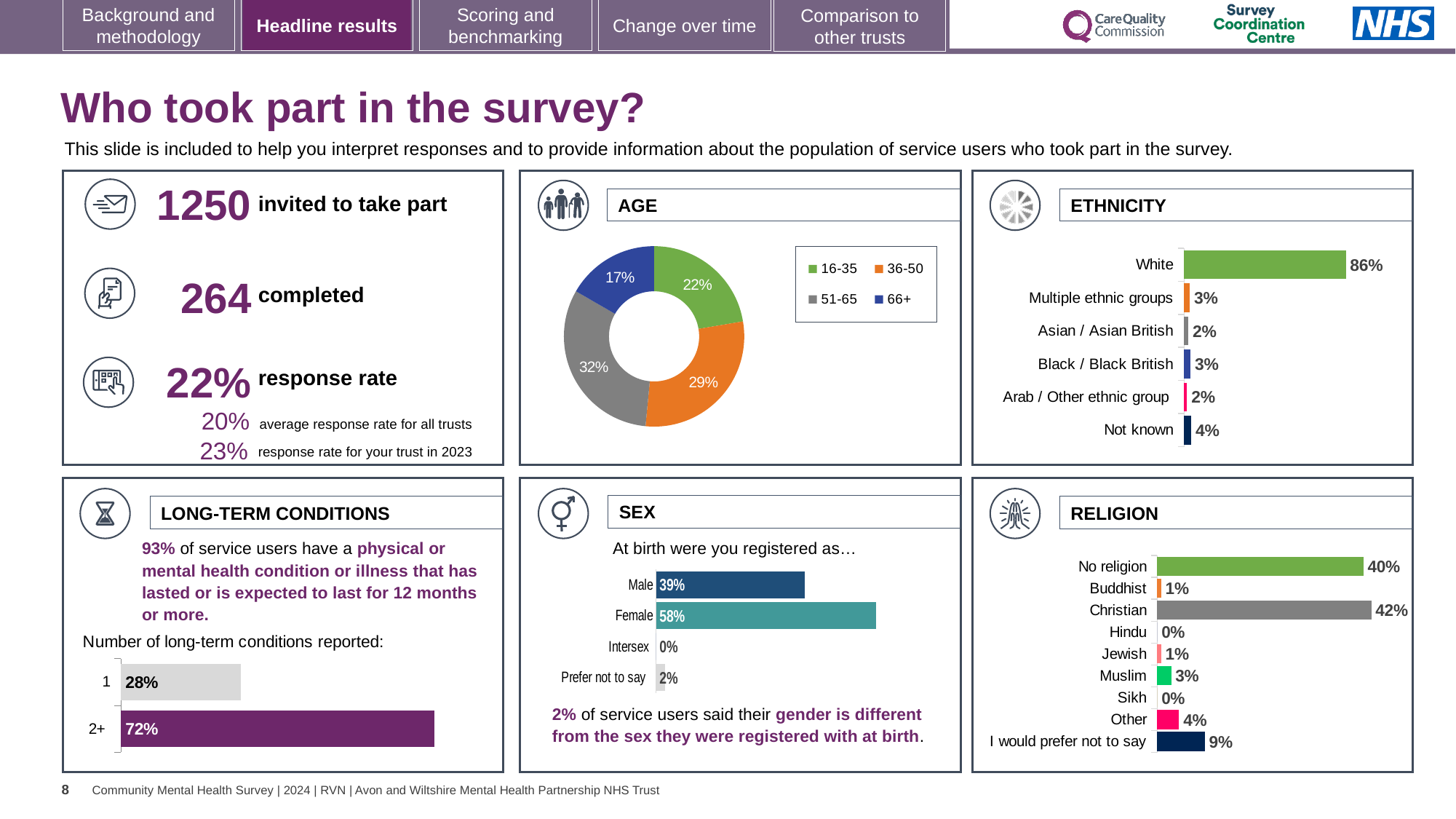
In the ETHNICITY chart, what is the value for White? 86% What kind of chart is the AGE chart? Doughnut chart In the AGE chart, what percentage of respondents were aged 51-65? 32% How many ethnicity categories are shown in the ETHNICITY chart? 6 In the RELIGION chart, what is the difference between Christian and No religion? 2% In the AGE chart, which age group has the smallest share? 66+ In the SEX chart, what is the value for Prefer not to say? 2% In the SEX chart, which is larger, Male or Female? Female How many age groups does the legend of the AGE chart list? 4 In the ETHNICITY chart, what is the difference between White and Not known? 82% In the RELIGION chart, which category has the highest value? Christian In the LONG-TERM CONDITIONS chart, what percentage reported 2+ long-term conditions? 72%